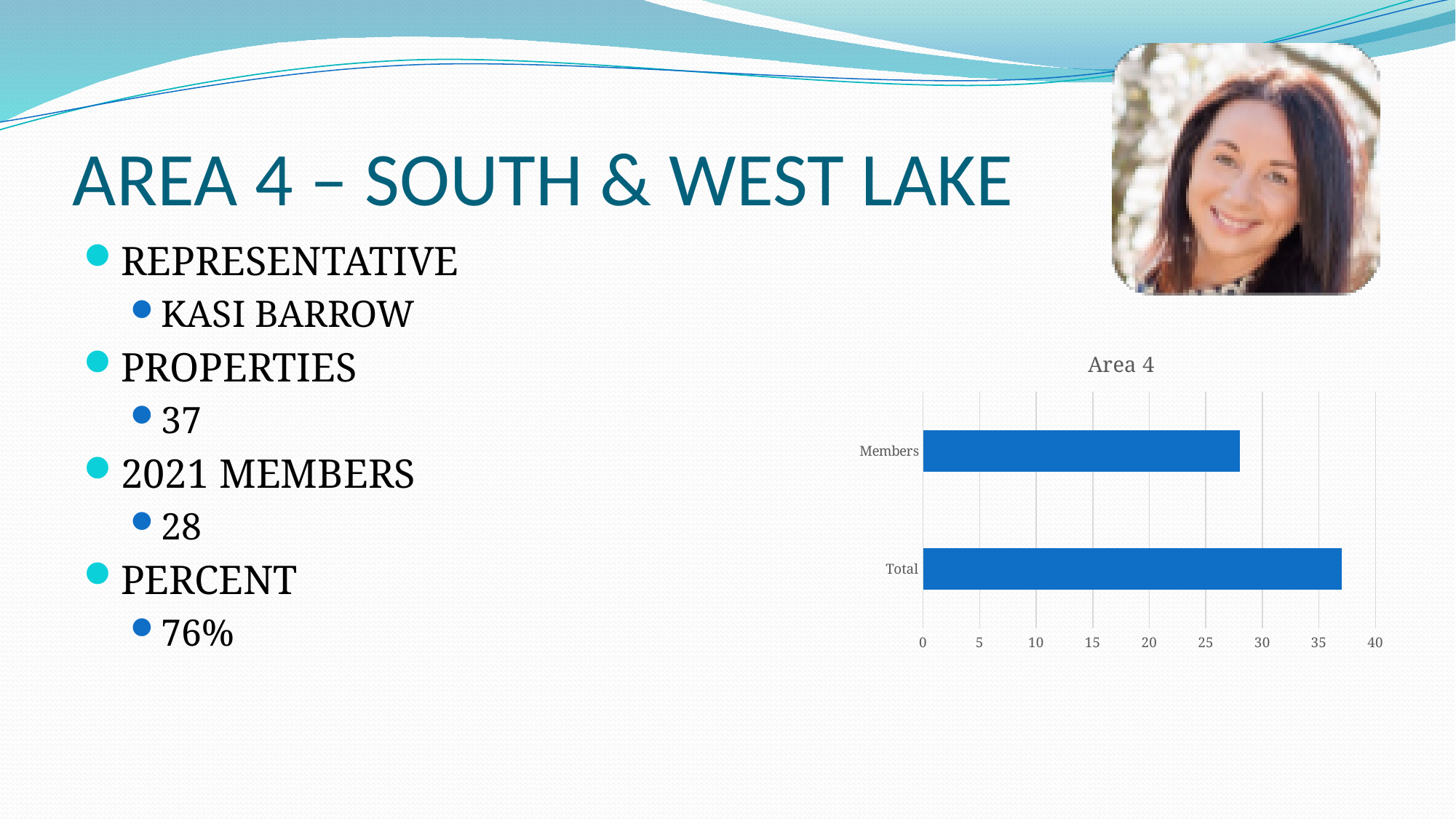
Which category has the highest value in the chart? Total What is the title of the chart? Area 4 Is the value for Members greater or less than 30? less Is the value for Total greater or less than 40? less What is the maximum value shown on the chart's horizontal axis? 40 Which category has the lowest value in the chart? Members What kind of chart is shown on the slide? bar chart Which category is listed at the top of the chart? Members Is the value for Total greater or less than 35? greater Which is larger in the chart, Members or Total? Total How many categories does the chart show? 2